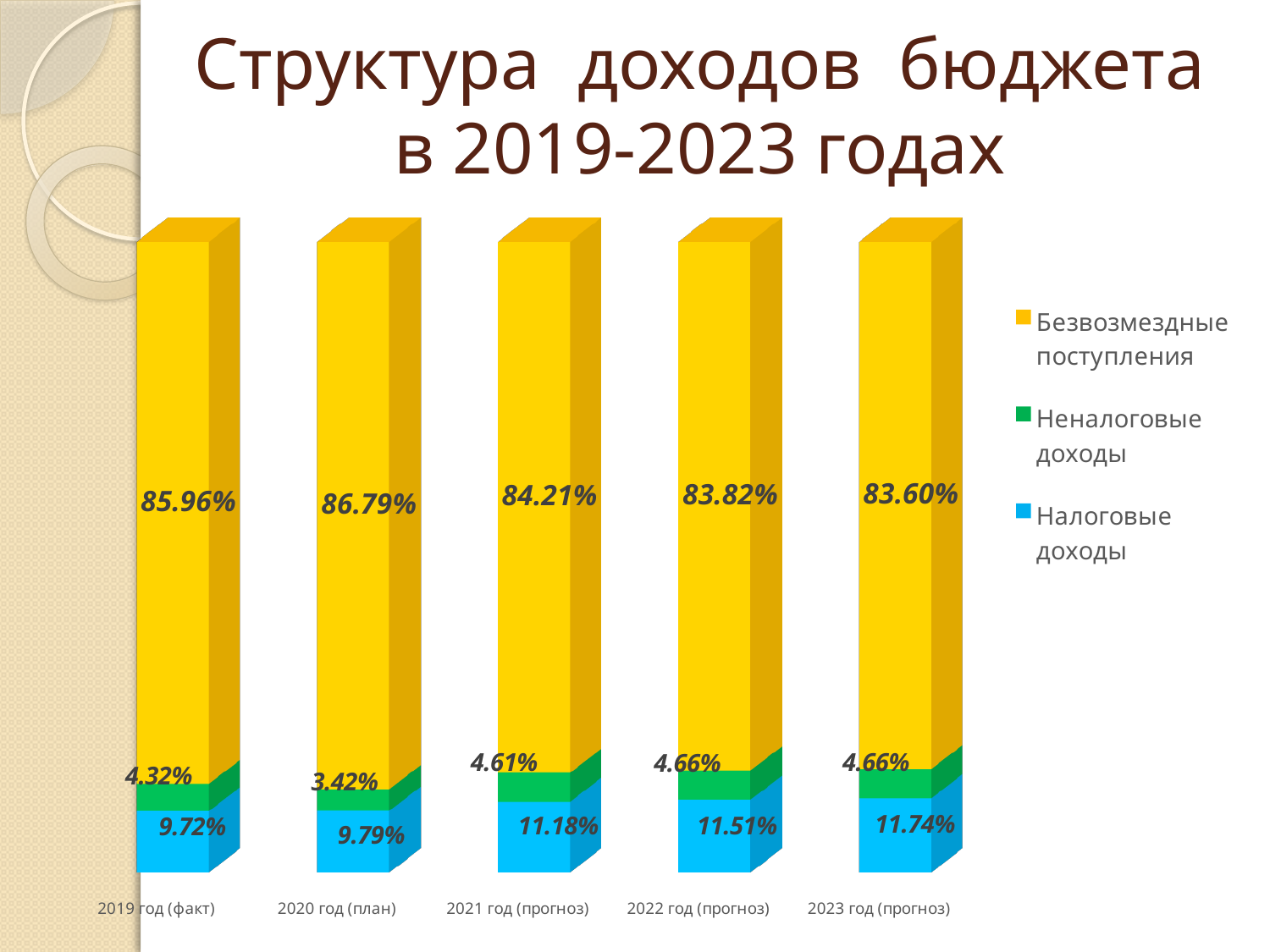
What is the value of Неналоговые доходы for 2020 год (план)? 3.42% How many series does the legend list? 3 In which year is the share of Безвозмездные поступления the highest? 2020 год (план) What is the value of Безвозмездные поступления for 2019 год (факт)? 85.96% What type of chart is shown on the slide? Stacked bar chart Which is larger: Неналоговые доходы in 2021 год (прогноз) or in 2020 год (план)? 2021 год (прогноз) Does the share of Налоговые доходы rise or fall from 2019 to 2023? Rise In which year is the share of Налоговые доходы the lowest? 2019 год (факт) How many categories (years) are shown on the x axis? 5 What is the value of Налоговые доходы for 2023 год (прогноз)? 11.74% Which series is shown in yellow in the legend? Безвозмездные поступления What is the difference between the Налоговые доходы values for 2023 год (прогноз) and 2019 год (факт)? 2.02%